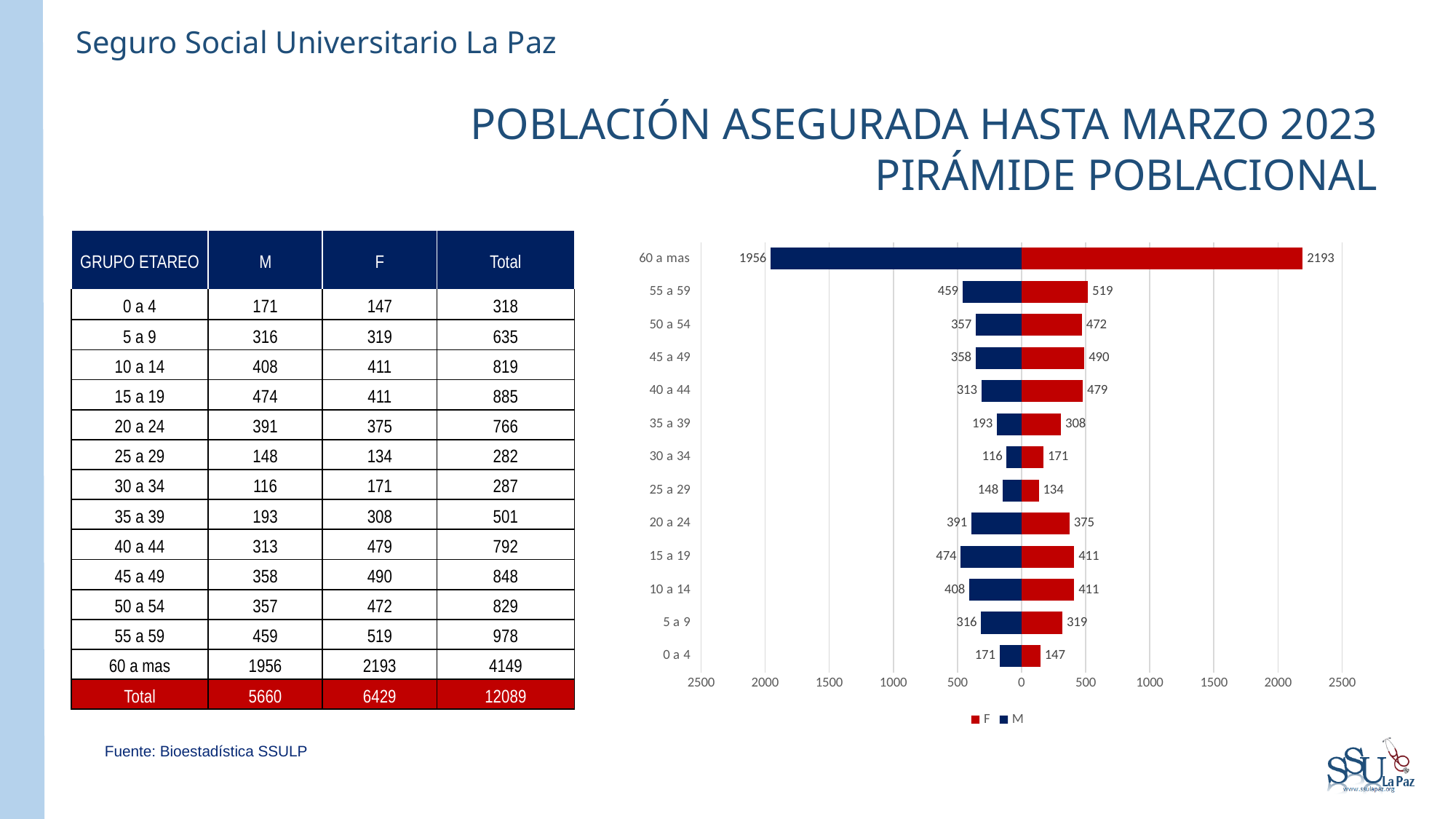
For the 15 a 19 age group, which is larger, M or F? M What is the M value for the 60 a mas age group? 1956 Which age group has the lowest F value? 25 a 29 What kind of chart is shown on the slide? Bar chart What is the F value for the 35 a 39 age group? 308 What colour represents the F series in the chart? Red Which age group has the highest F value? 60 a mas How many series does the chart legend list? 2 How many age groups are shown on the chart? 13 What is the difference between the F and M values for the 60 a mas age group? 237 Which age group has the lowest M value? 30 a 34 What is the combined M and F value for the 40 a 44 age group? 792